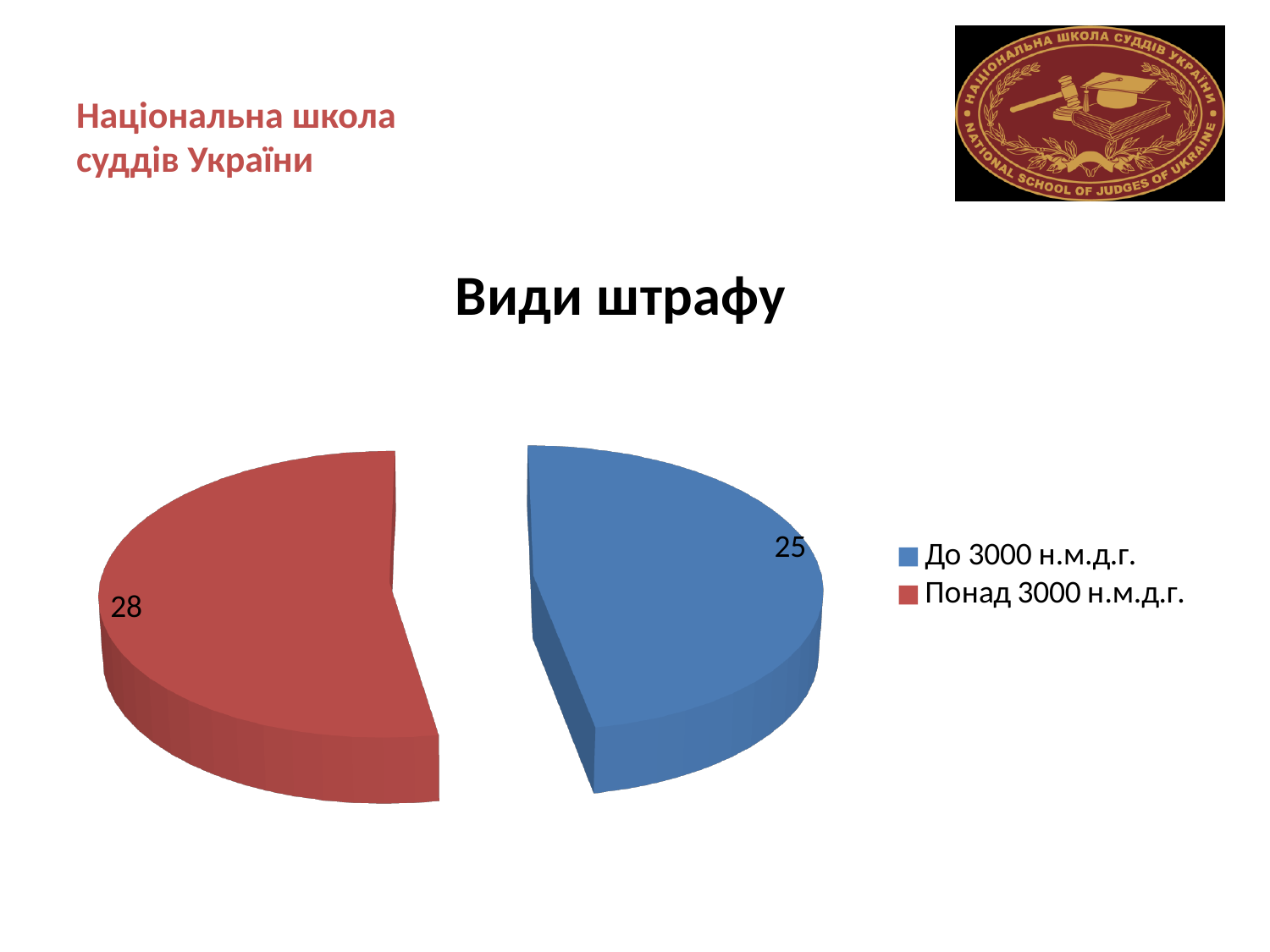
What is the value for the slice 'Понад 3000 н.м.д.г.'? 28 What kind of chart is shown on the slide? Pie chart How many entries does the legend list? 2 Which is larger, the value for 'До 3000 н.м.д.г.' or for 'Понад 3000 н.м.д.г.'? Понад 3000 н.м.д.г. How many categories are shown in the pie chart? 2 What is the difference between the values for 'Понад 3000 н.м.д.г.' and 'До 3000 н.м.д.г.'? 3 Which category has the largest slice of the pie? Понад 3000 н.м.д.г. What colour is the slice for 'Понад 3000 н.м.д.г.'? Red Which category has the smallest slice of the pie? До 3000 н.м.д.г. What is the total of the two slice values in the pie chart? 53 What is the title of the chart? Види штрафу What is the value for the slice 'До 3000 н.м.д.г.'? 25